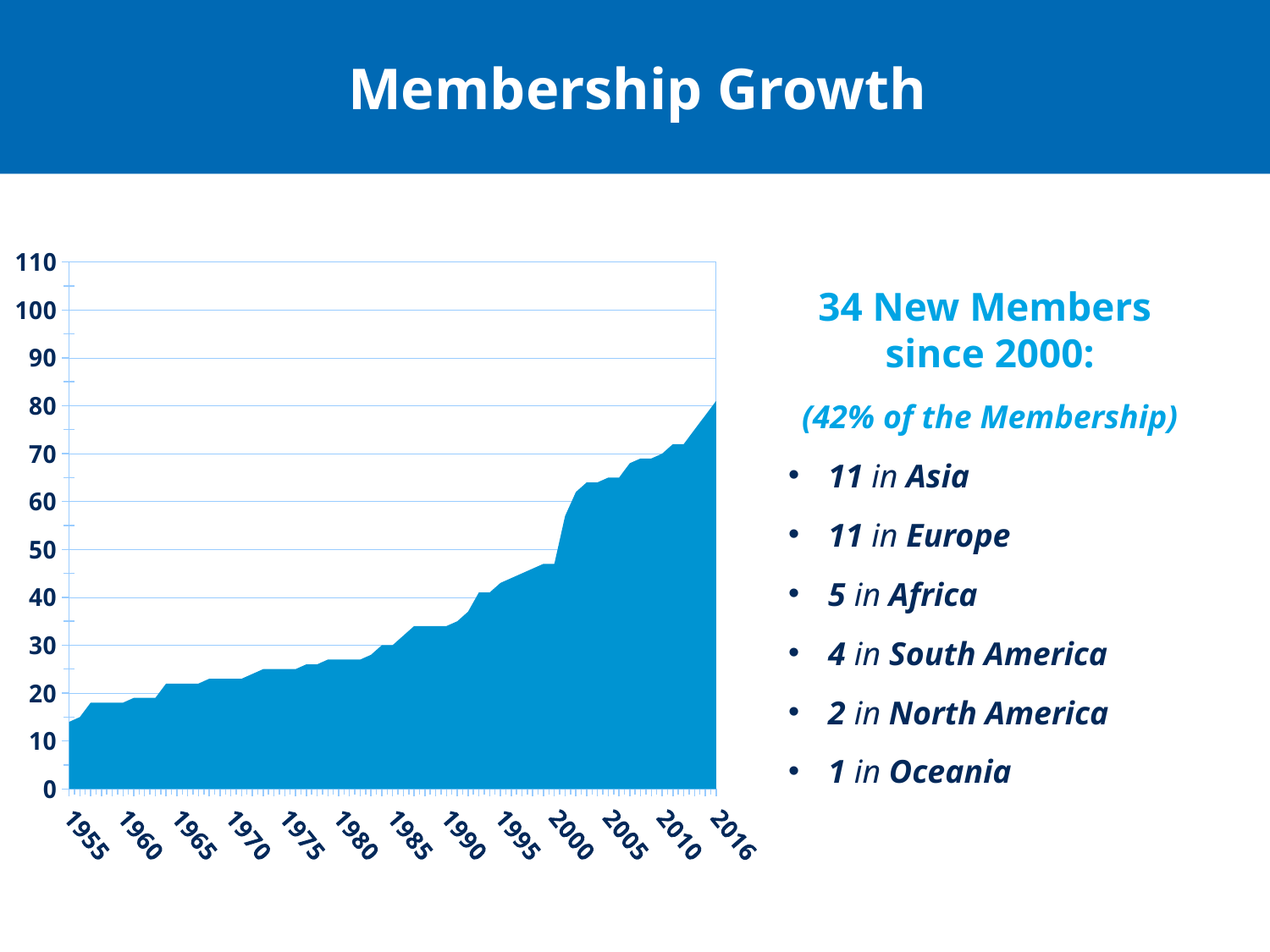
Which year on the x axis has the lowest value in the chart? 1955 How many year labels are shown on the x axis of the chart? 13 Which year on the x axis has the highest value in the chart? 2016 Which is larger, the value for 1990 or the value for 2005? 2005 What kind of chart is shown on the slide? area chart Is the value for 2010 greater or less than 60? greater Do the values in the chart generally rise or fall from 1955 to 2016? rise Is the value for 1955 greater or less than 20? less What is the highest tick value shown on the y axis of the chart? 110 Is the value for 2016 greater or less than 70? greater